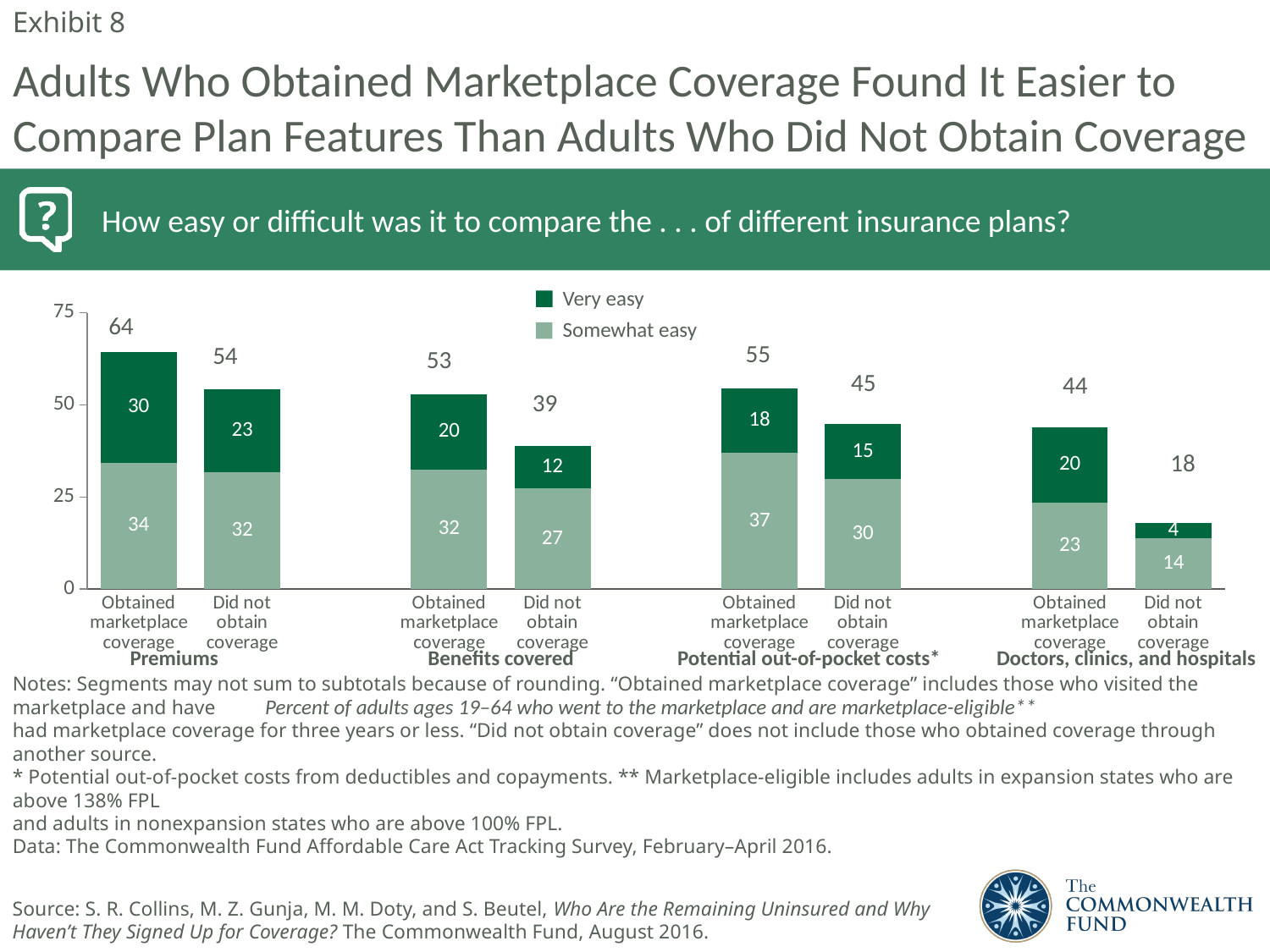
What is the 'Very easy' value for adults who did not obtain coverage in the Doctors, clinics, and hospitals group? 4 How many series does the legend list? 2 Which bar has the highest total value on the chart? Obtained marketplace coverage, Premiums (64) What is the total value shown above the bar for adults who obtained marketplace coverage in the Premiums group? 64 Which legend entry is shown in the darker green colour? Very easy What kind of chart is shown on the slide? Stacked bar chart Which bar has the lowest total value on the chart? Did not obtain coverage, Doctors, clinics, and hospitals (18) What is the 'Somewhat easy' value for adults who obtained marketplace coverage in the Potential out-of-pocket costs group? 37 In the Benefits covered group, which has a larger total: adults who obtained marketplace coverage or adults who did not obtain coverage? Obtained marketplace coverage How many bars are plotted on the chart? 8 What is the 'Very easy' value for adults who did not obtain coverage in the Benefits covered group? 12 What is the difference between the total values for adults who obtained marketplace coverage and adults who did not obtain coverage in the Doctors, clinics, and hospitals group? 26